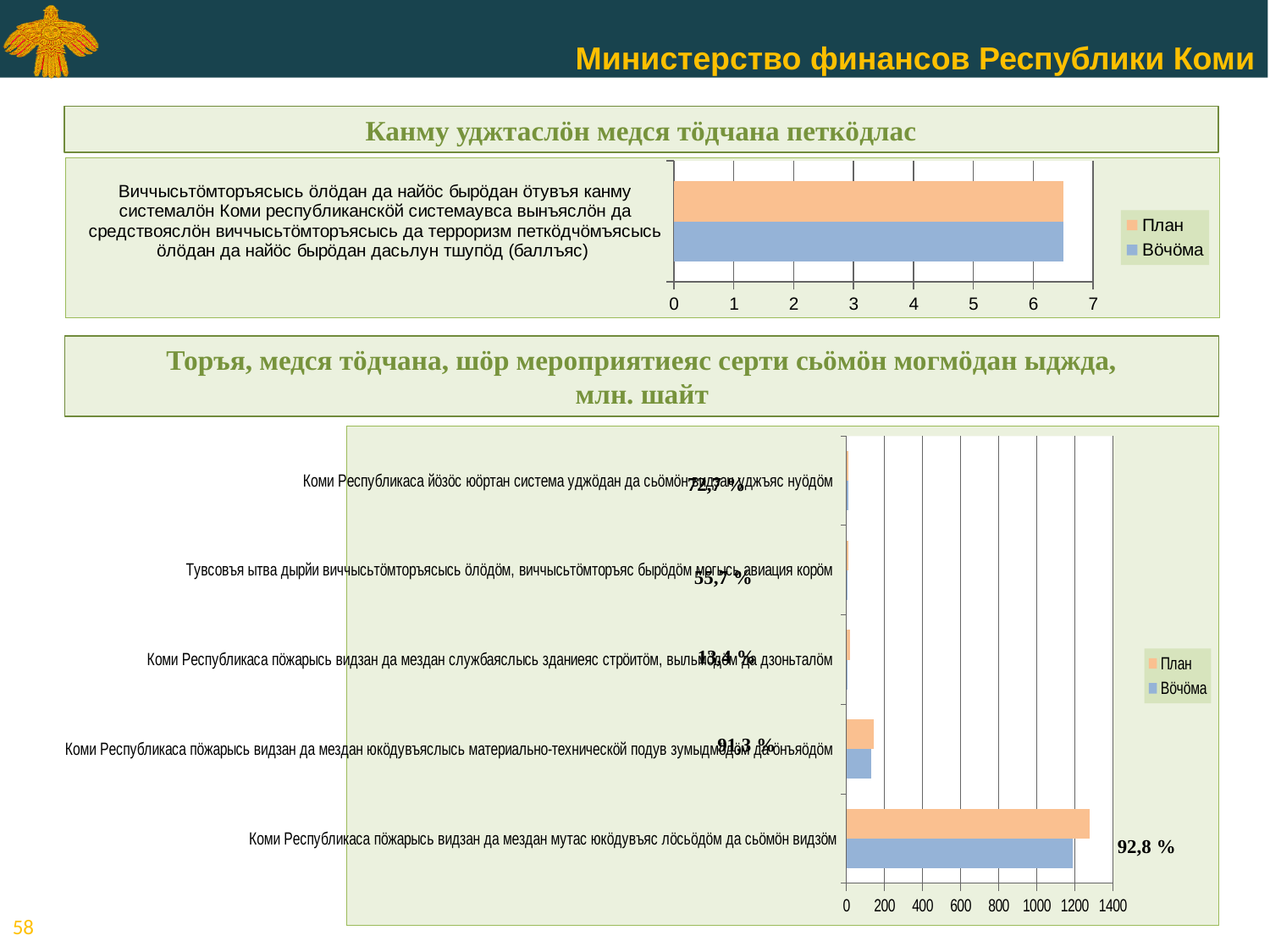
In the bottom chart "Торъя, медся тӧдчана, шӧр мероприятиеяс серти сьӧмӧн могмӧдан ыджда, млн. шайт", for "Коми Республикаса пӧжарысь видзан да мездан мутас юкӧдувъяс лӧсьӧдӧм да сьӧмӧн видзӧм", which is larger: План or Вӧчӧма? План In the top chart "Канму уджтаслӧн медся тӧдчана петкӧдлас", is the value for План greater or less than 6? greater In the bottom chart "Торъя, медся тӧдчана, шӧр мероприятиеяс серти сьӧмӧн могмӧдан ыджда, млн. шайт", what are the two legend entries? План, Вӧчӧма In the top chart "Канму уджтаслӧн медся тӧдчана петкӧдлас", how many categories are plotted? 1 In the bottom chart "Торъя, медся тӧдчана, шӧр мероприятиеяс серти сьӧмӧн могмӧдан ыджда, млн. шайт", which category has the highest План value? Коми Республикаса пӧжарысь видзан да мездан мутас юкӧдувъяс лӧсьӧдӧм да сьӧмӧн видзӧм What kind of chart is the top chart titled "Канму уджтаслӧн медся тӧдчана петкӧдлас"? bar chart In the bottom chart "Торъя, медся тӧдчана, шӧр мероприятиеяс серти сьӧмӧн могмӧдан ыджда, млн. шайт", how many categories are plotted? 5 In the bottom chart "Торъя, медся тӧдчана, шӧр мероприятиеяс серти сьӧмӧн могмӧдан ыджда, млн. шайт", what percentage label is shown next to the bars for "Коми Республикаса пӧжарысь видзан да мездан мутас юкӧдувъяс лӧсьӧдӧм да сьӧмӧн видзӧм"? 92,8 % In the top chart "Канму уджтаслӧн медся тӧдчана петкӧдлас", how many series does the legend list? 2 In the bottom chart "Торъя, медся тӧдчана, шӧр мероприятиеяс серти сьӧмӧн могмӧдан ыджда, млн. шайт", is the План value for "Коми Республикаса пӧжарысь видзан да мездан мутас юкӧдувъяс лӧсьӧдӧм да сьӧмӧн видзӧм" greater or less than 1200? greater In the top chart "Канму уджтаслӧн медся тӧдчана петкӧдлас", is the value for Вӧчӧма greater or less than 7? less